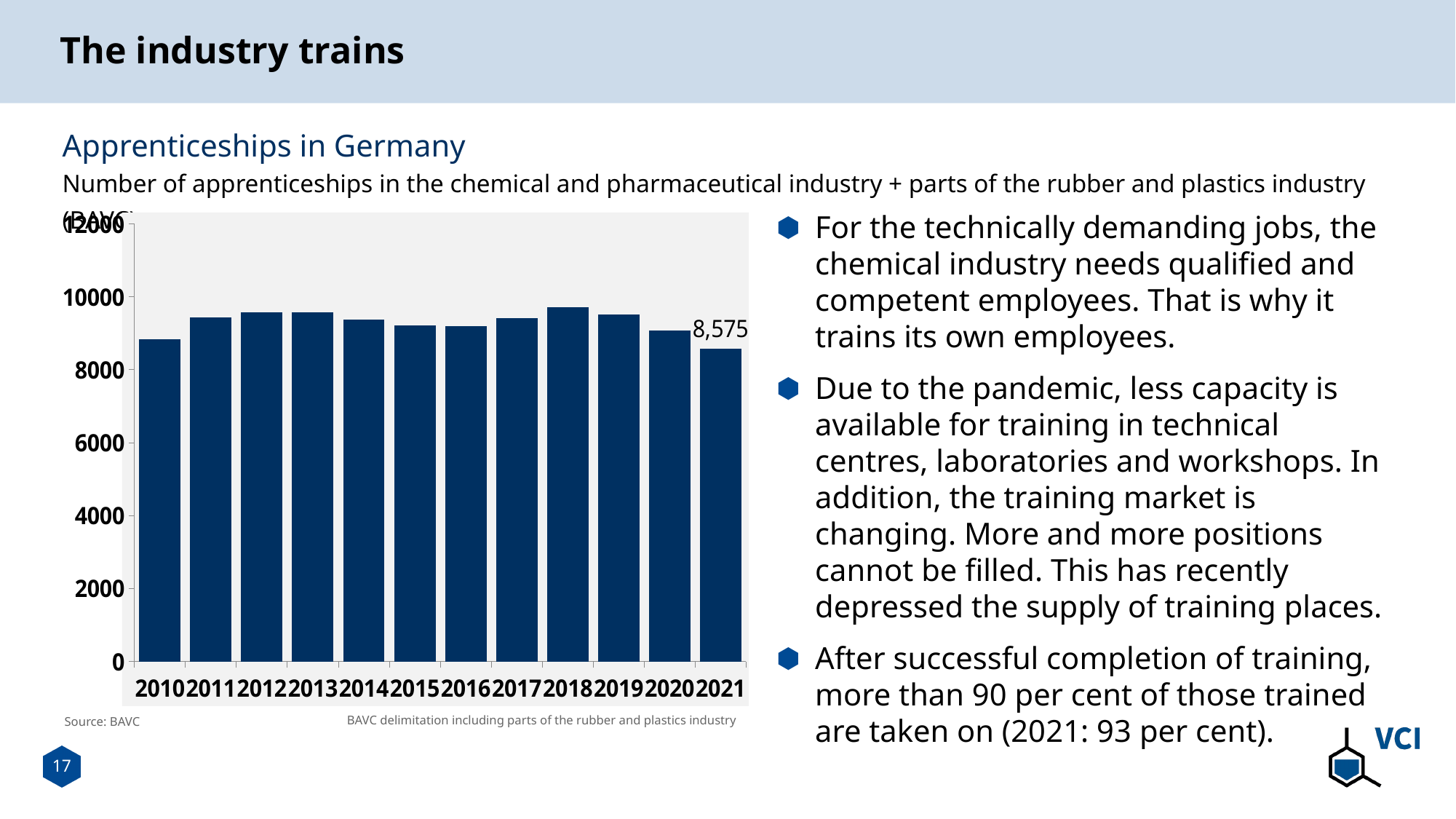
Which year has the larger value, 2010 or 2012? 2012 How many years are shown on the x axis of the chart? 12 Do the values rise or fall from 2018 to 2021? Fall Which year has the lowest number of apprenticeships? 2021 What is the source given for the chart? BAVC What is the title of the chart? Apprenticeships in Germany Is the value for 2010 greater or less than 8000? greater Is the value for 2021 greater or less than 10000? less Which year has the larger value, 2018 or 2021? 2018 Is the value for 2018 greater or less than 10000? less What is the number of apprenticeships shown for 2021? 8,575 What kind of chart is used to show the apprenticeships data? Bar chart